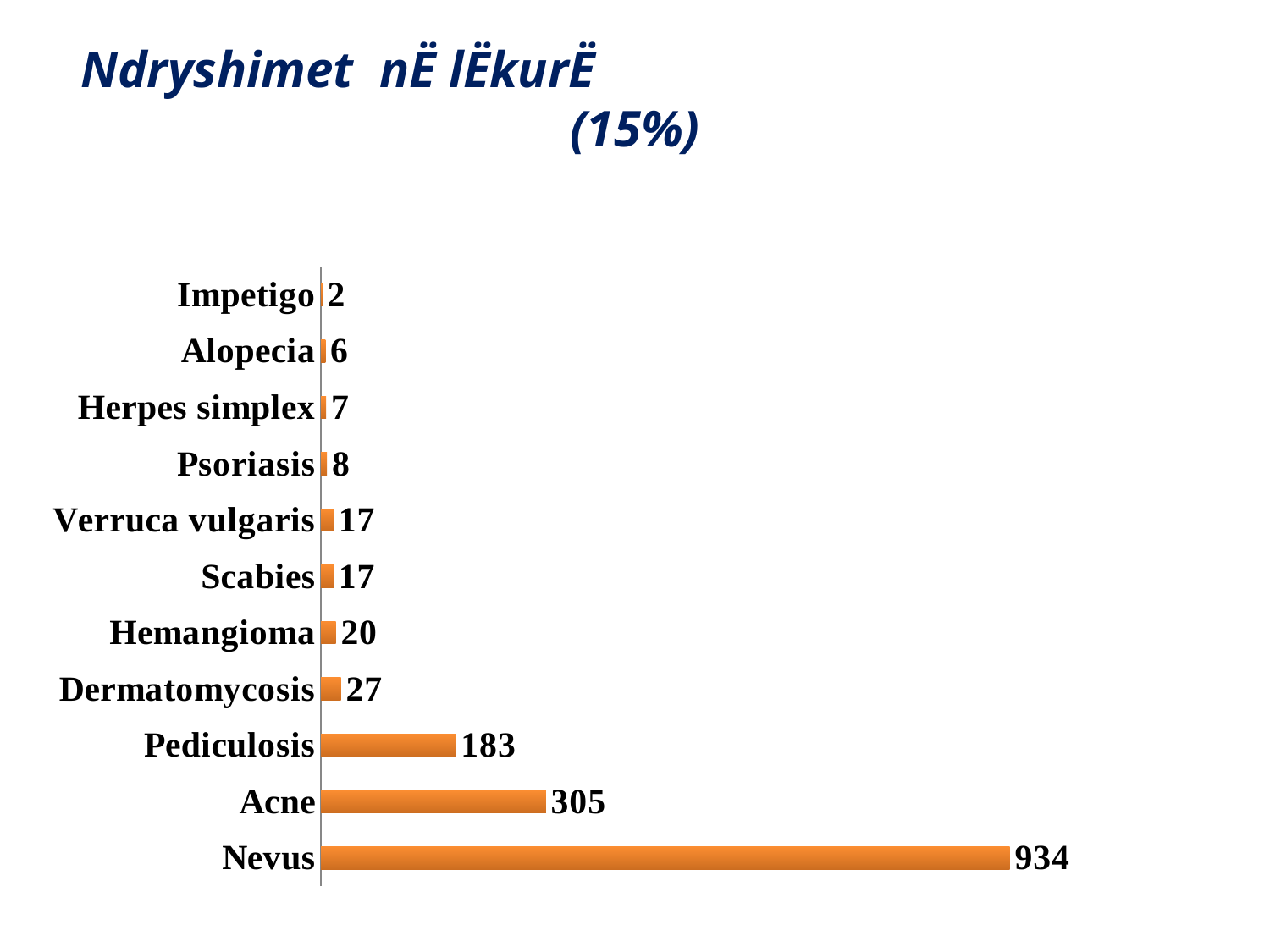
What is the value for Pediculosis? 183 What colour are the bars in the chart? Orange Which is larger, the value for Hemangioma or the value for Psoriasis? Hemangioma What is the difference between the values for Acne and Pediculosis? 122 What is the value for Dermatomycosis? 27 What kind of chart is shown on the slide? Bar chart What is the value for Herpes simplex? 7 How many categories are shown in the chart? 11 What is the value for Nevus? 934 Which category has the lowest value? Impetigo What is the difference between the values for Nevus and Acne? 629 Which category has the highest value? Nevus